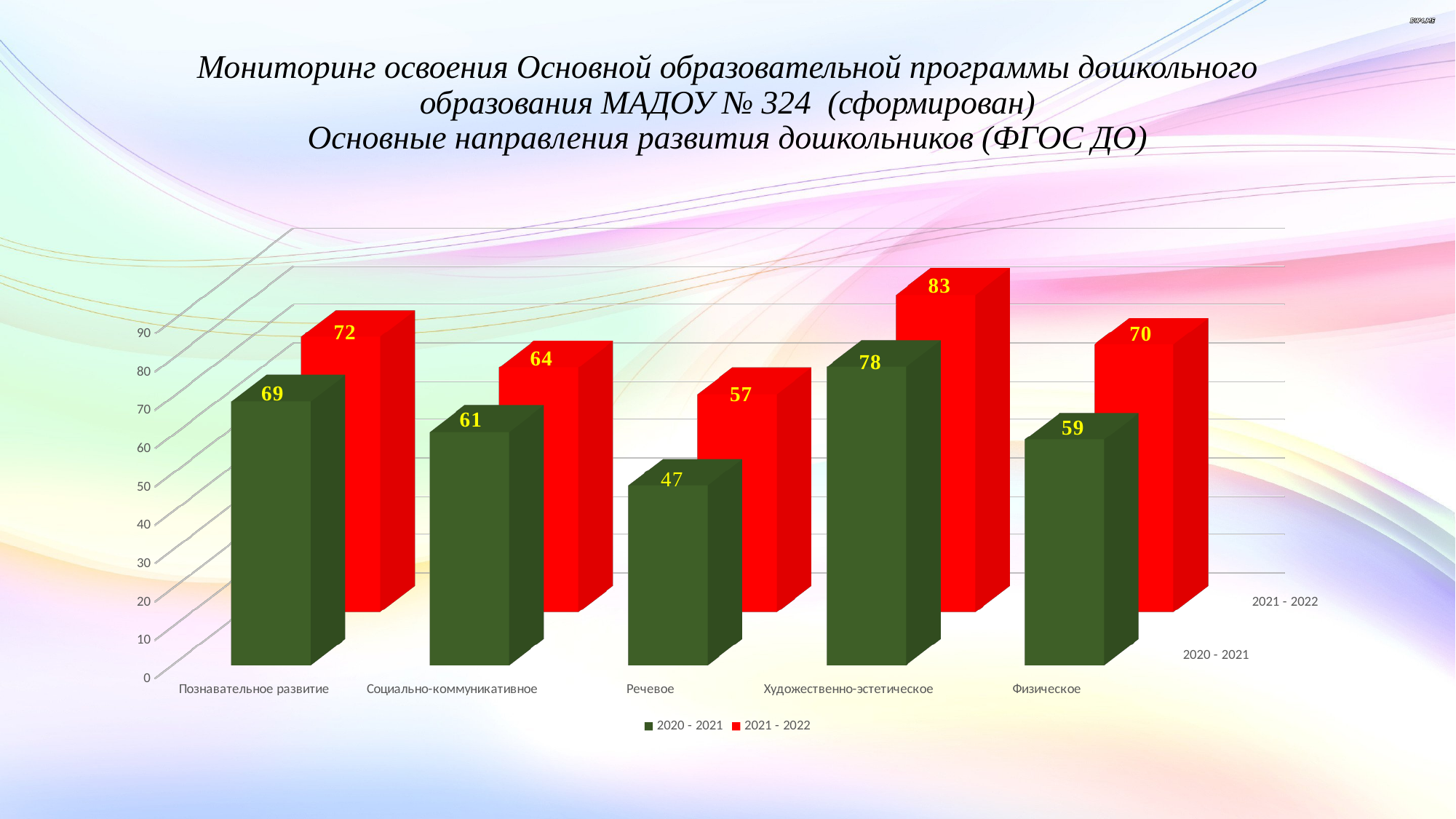
What is the value for Художественно-эстетическое in the 2021 - 2022 series? 83 What is the value for Речевое in the 2020 - 2021 series? 47 Which is larger for Социально-коммуникативное: the 2020 - 2021 value or the 2021 - 2022 value? 2021 - 2022 Which category has the lowest value in the 2020 - 2021 series? Речевое What kind of chart is shown on the slide? Bar chart What is the value for Физическое in the 2021 - 2022 series? 70 Which category has the highest value in the 2021 - 2022 series? Художественно-эстетическое How many series does the legend list? 2 What is the value for Познавательное развитие in the 2020 - 2021 series? 69 What is the difference between the 2021 - 2022 and 2020 - 2021 values for Речевое? 10 Which colour represents the 2021 - 2022 series? Red How many categories are shown on the x axis? 5